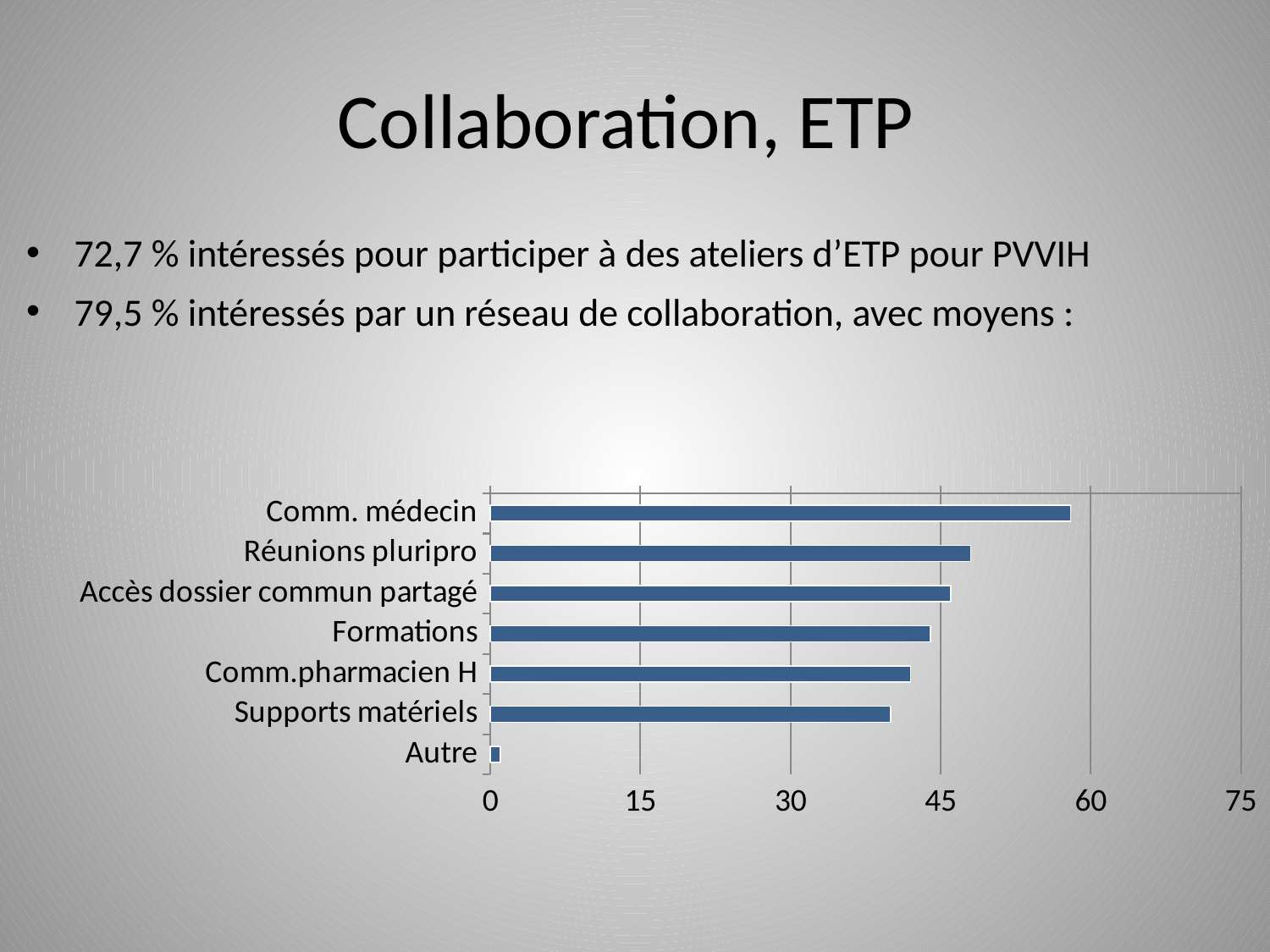
Which category has the lowest value in the bar chart? Autre Is the value for Supports matériels greater or less than 45? less Is the value for Comm.pharmacien H greater or less than 30? greater Which is larger, the value for Comm. médecin or the value for Supports matériels? Comm. médecin How many categories are plotted in the bar chart? 7 Is the value for Comm. médecin greater or less than 45? greater What kind of chart is shown on the slide? bar chart Which is larger, the value for Formations or the value for Autre? Formations Which category has the highest value in the bar chart? Comm. médecin What is the highest tick value shown on the horizontal axis of the chart? 75